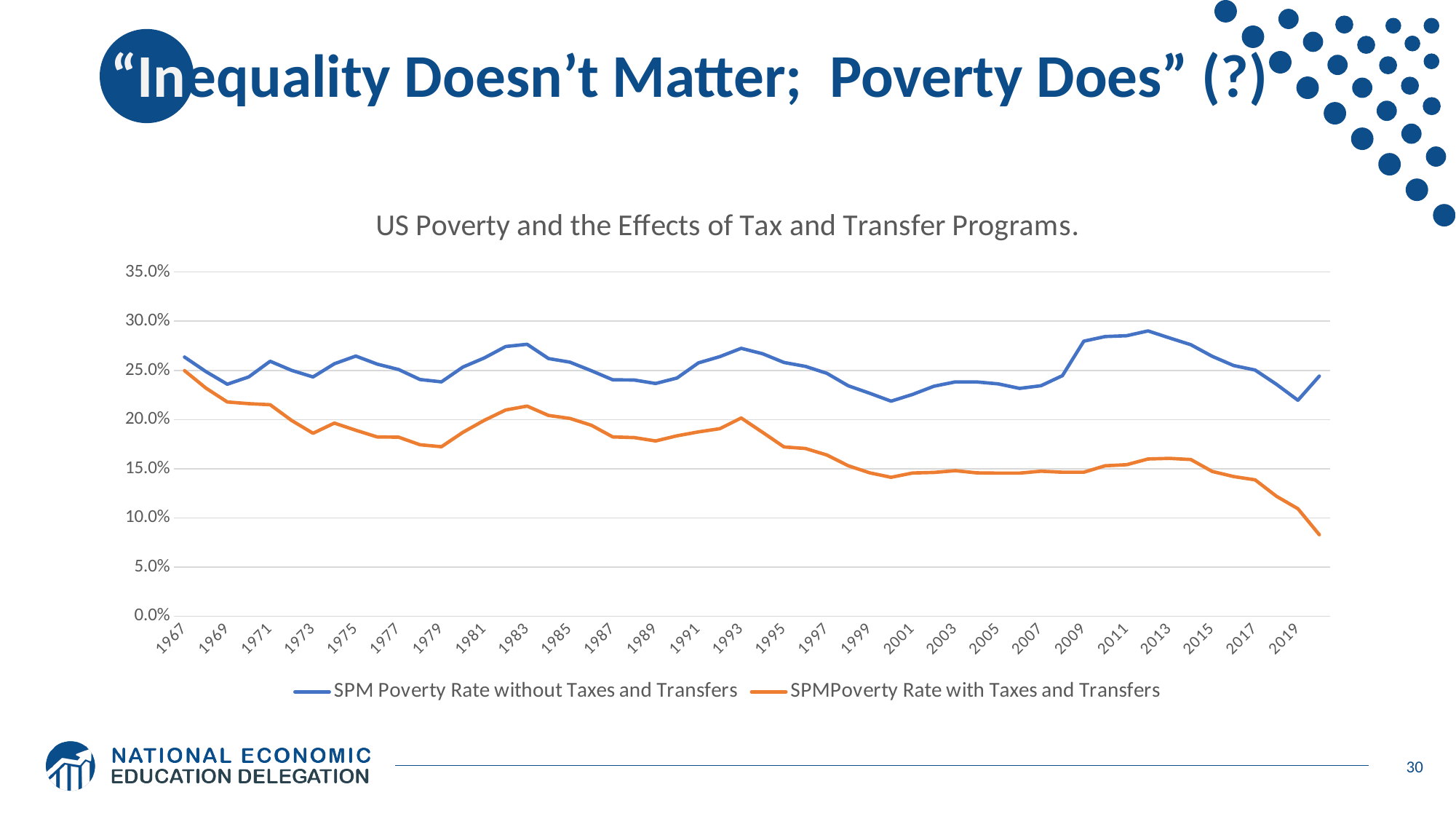
What colour is the line for the SPM Poverty Rate with Taxes and Transfers? Orange In 2019, which series has the higher value: SPM Poverty Rate without Taxes and Transfers or SPM Poverty Rate with Taxes and Transfers? SPM Poverty Rate without Taxes and Transfers Is the value for SPM Poverty Rate with Taxes and Transfers in 1979 greater or less than 20.0%? less Is the value for SPM Poverty Rate with Taxes and Transfers in 1967 greater or less than 20.0%? greater Is the value for SPM Poverty Rate with Taxes and Transfers in 2019 greater or less than 15.0%? less What kind of chart is shown on the slide? Line chart Does the SPM Poverty Rate without Taxes and Transfers rise or fall between 2007 and 2011? Rise How many series does the chart's legend list? 2 Does the SPM Poverty Rate with Taxes and Transfers rise or fall between 2013 and 2019? Fall What is the title of the chart? US Poverty and the Effects of Tax and Transfer Programs.